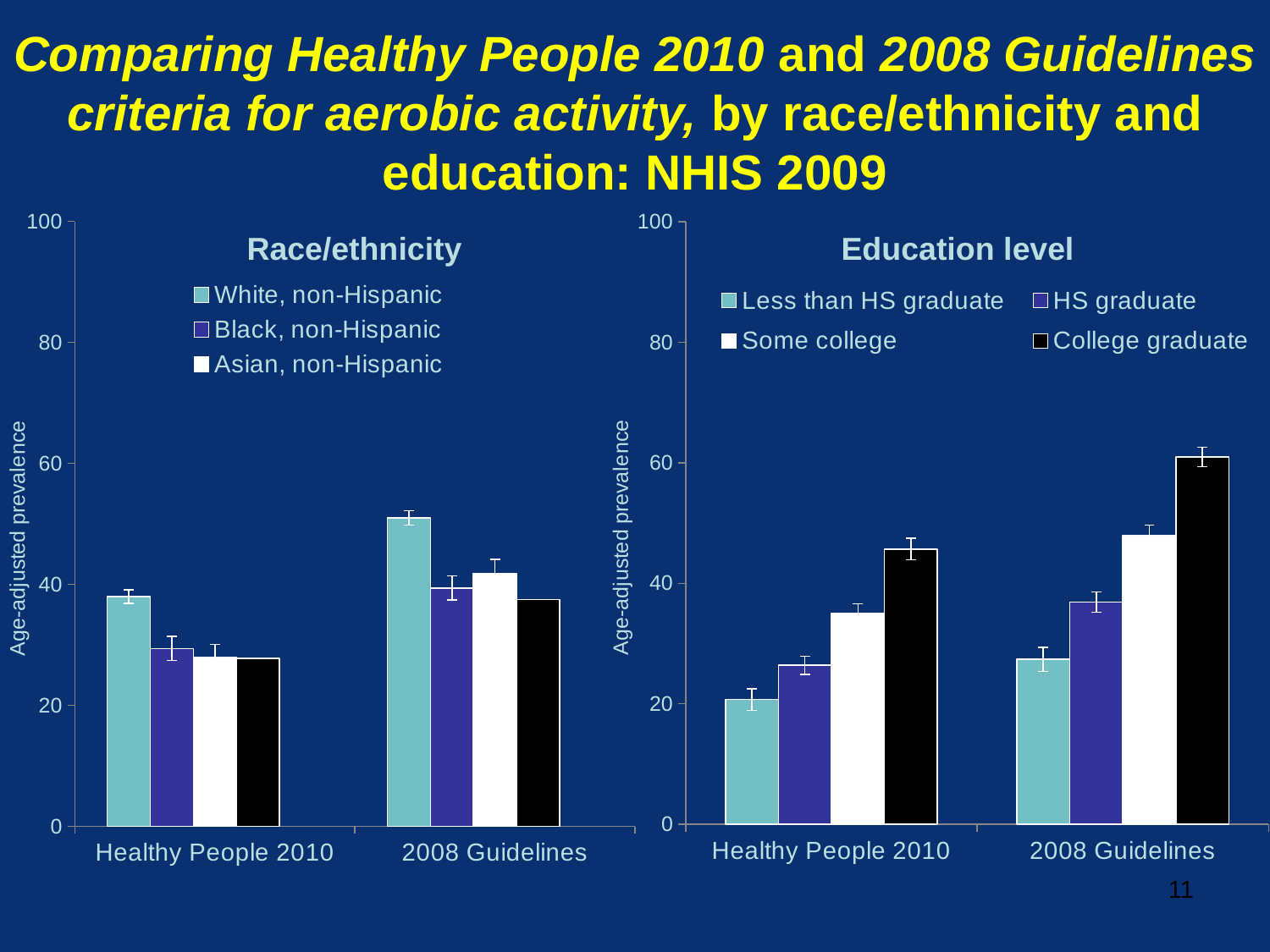
How many categories are shown on the x axis of the Education level chart? 2 In the Race/ethnicity chart, is the value for Black, non-Hispanic under Healthy People 2010 greater or less than 40? less In the Education level chart, which education level has the highest value under 2008 Guidelines? College graduate What is the y-axis label of the Race/ethnicity chart? Age-adjusted prevalence How many series does the legend of the Education level chart list? 4 In the Race/ethnicity chart, is the value for White, non-Hispanic under 2008 Guidelines greater or less than 40? greater How many series does the legend of the Race/ethnicity chart list? 3 In the Education level chart, which education level has the lowest value under Healthy People 2010? Less than HS graduate In the Education level chart, is the value for College graduate under Healthy People 2010 greater or less than 40? greater What kind of chart is the Race/ethnicity chart on the left? Bar chart In the Race/ethnicity chart, is the value for White, non-Hispanic larger under Healthy People 2010 or under 2008 Guidelines? 2008 Guidelines